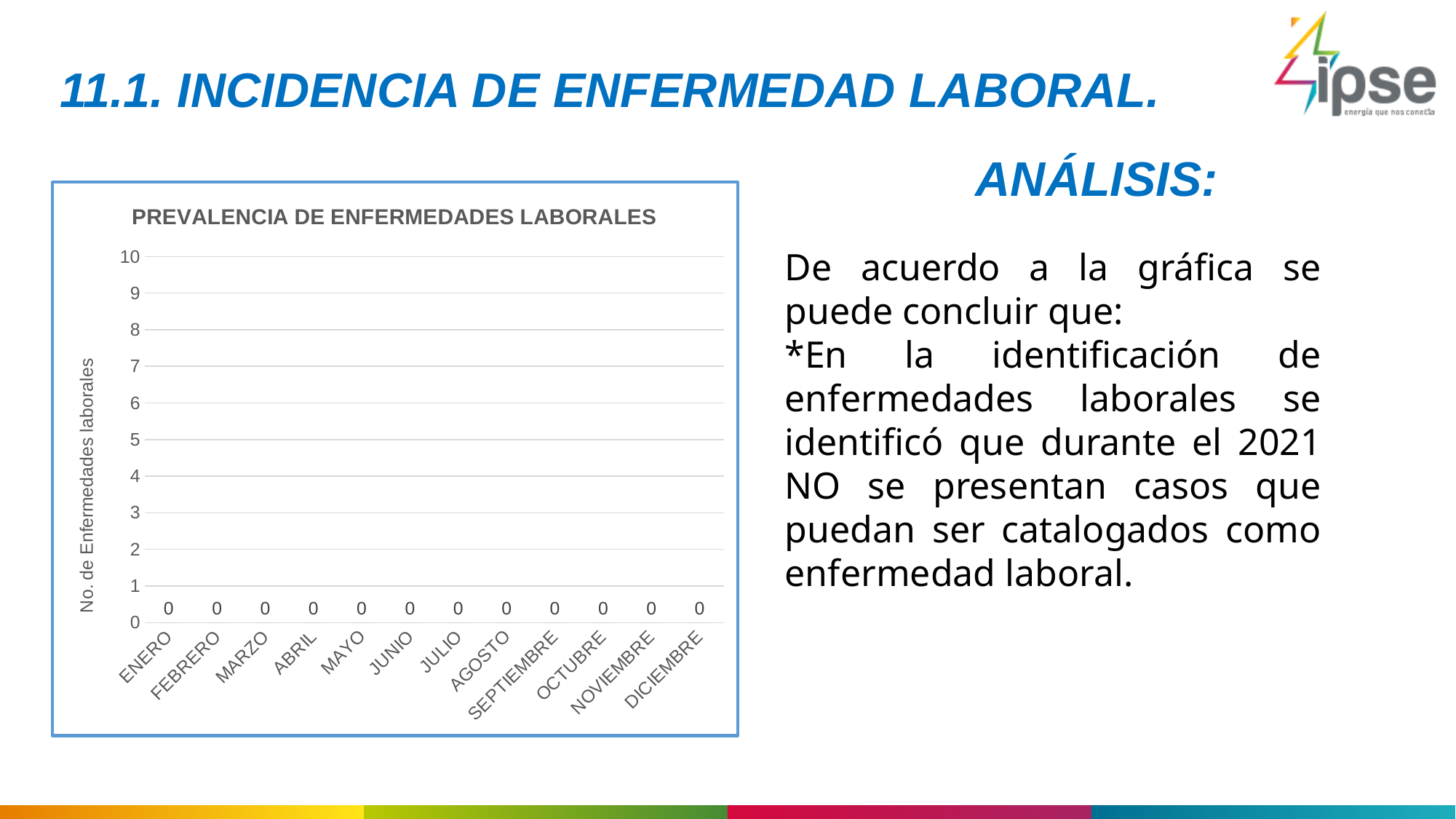
How many months are shown on the x axis of the chart? 12 What is the label of the vertical axis of the chart? No. de Enfermedades laborales What is the value for SEPTIEMBRE in the chart? 0 What is the value for DICIEMBRE in the chart? 0 What is the title of the chart? PREVALENCIA DE ENFERMEDADES LABORALES What is the highest tick value shown on the vertical axis? 10 What kind of chart is shown on the slide? bar chart What is the total of all the monthly values shown in the chart? 0 What is the difference between the values for MARZO and OCTUBRE? 0 Do the values rise, fall, or stay the same from ENERO to DICIEMBRE? stay the same Is the value for JULIO greater or less than 5? less What is the value for ENERO in the chart? 0